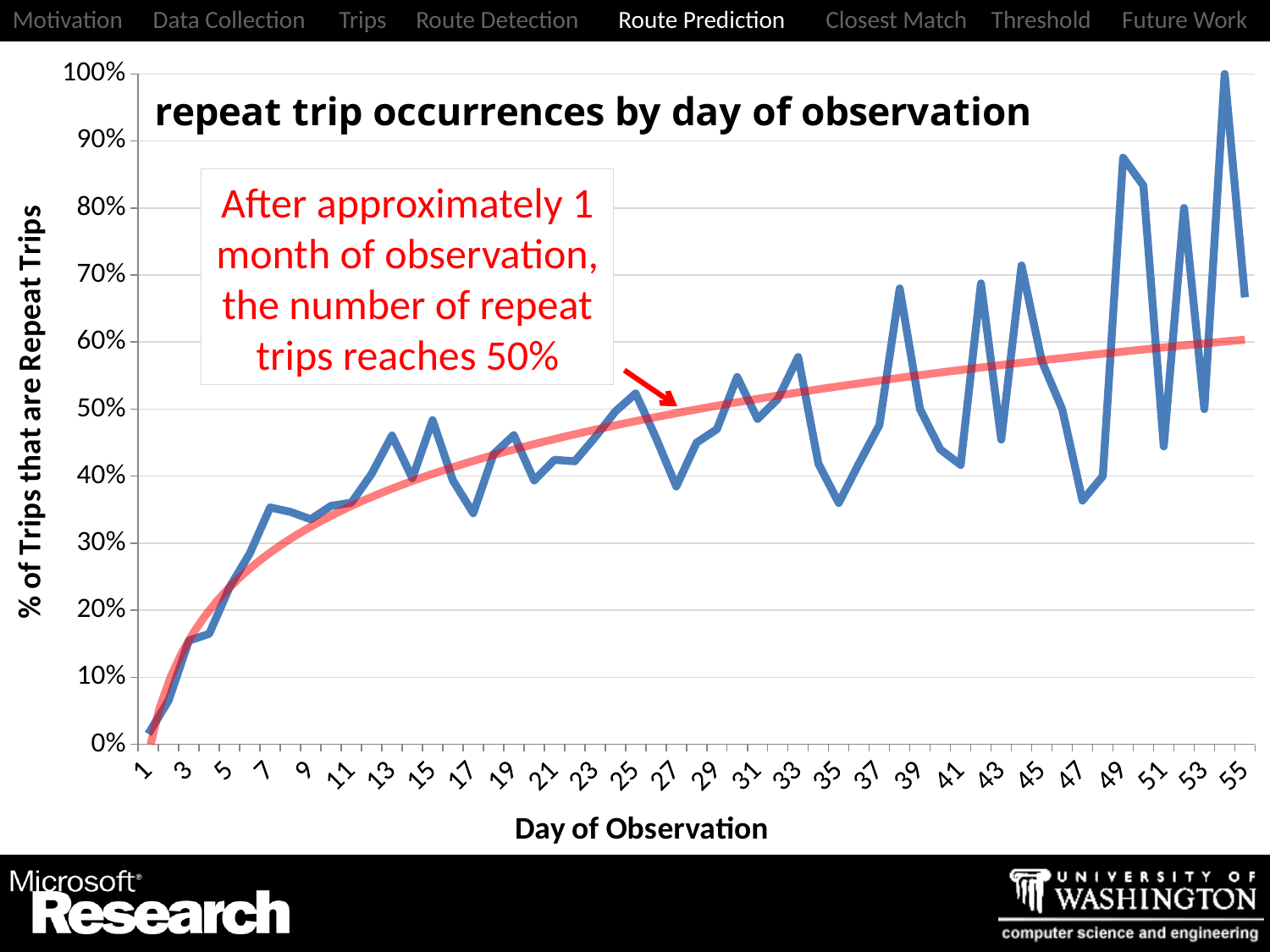
According to the annotation on the chart, what percentage do repeat trips reach after approximately 1 month of observation? 50% What is the title of the chart? repeat trip occurrences by day of observation Which has a higher value, day 47 or day 49? day 49 Is the value for day 49 greater or less than 80%? greater Is the value for day 1 greater or less than 10%? less What kind of chart is shown on the slide? line chart Is the value for day 39 greater or less than 60%? less Overall, do the values rise or fall as the day of observation increases? rise How many days of observation are plotted along the x axis? 55